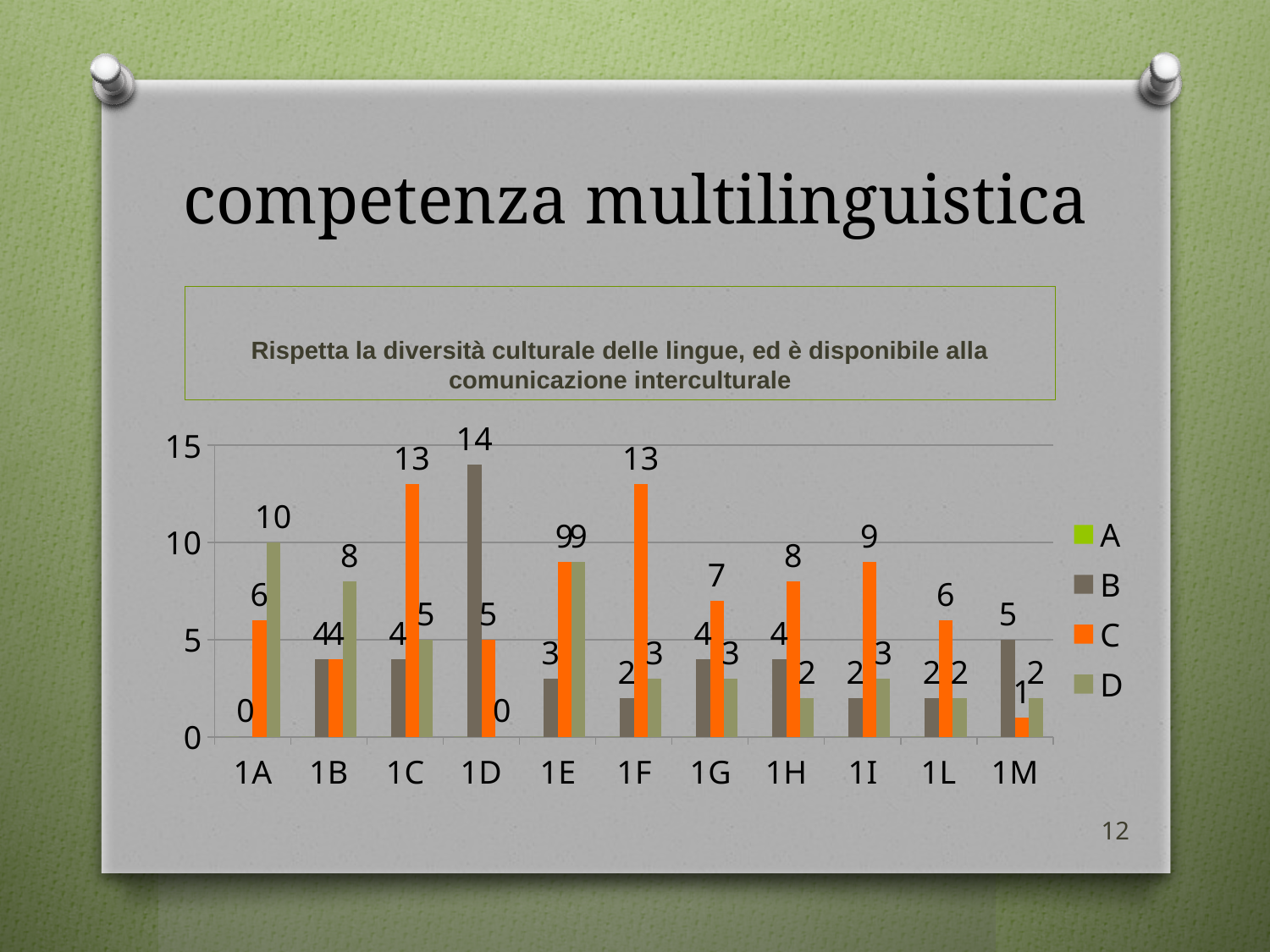
Which category has the lowest value for series C? 1M Which is larger: series D for 1A or series D for 1B? 1A What is the value of series D for category 1A? 10 Which category has the highest value for series B? 1D How many categories are shown on the x axis? 11 What is the value of series B for category 1D? 14 What type of chart is shown on the slide? bar chart Which category has the highest value for series D? 1A What is the value of series C for category 1C? 13 How many series does the legend list? 4 What is the difference between series C and series B for category 1C? 9 What is the value of series C for category 1M? 1